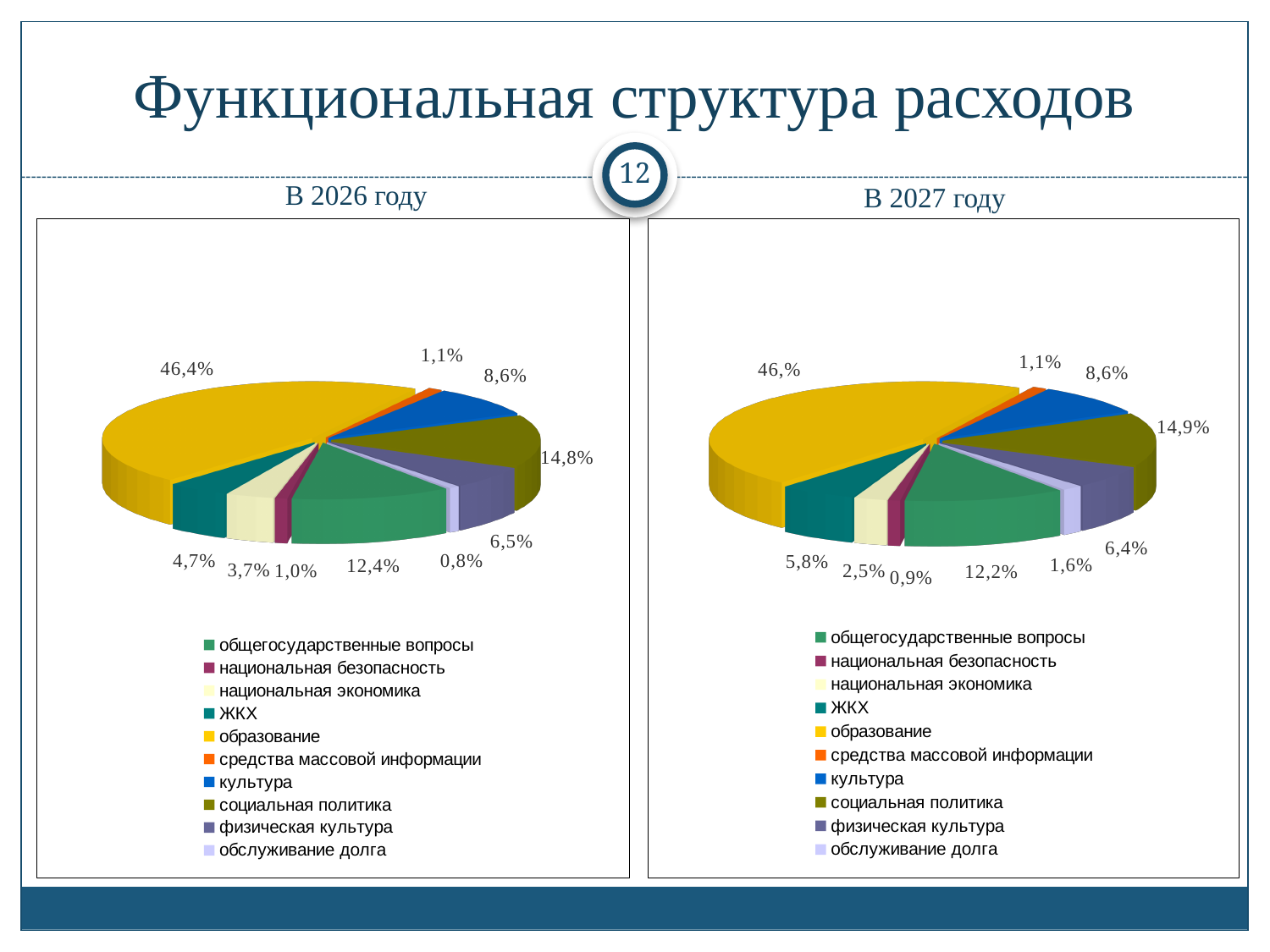
In the 'В 2026 году' chart, which category has the largest slice? образование In the 'В 2027 году' chart, which category has the smallest slice? национальная безопасность In the 'В 2026 году' chart, which category has the smallest slice? обслуживание долга In the 'В 2027 году' chart, which is larger: общегосударственные вопросы or культура? общегосударственные вопросы In the 'В 2027 году' chart, what share is shown for социальная политика? 14,9% In the 'В 2027 году' chart, what share is shown for ЖКХ? 5,8% What kind of chart is used on the slide for 'В 2026 году'? pie chart In the 'В 2026 году' chart, what is the difference in percentage points between общегосударственные вопросы (12,4%) and культура (8,6%)? 3,8 In the 'В 2026 году' chart, what share is shown for социальная политика? 14,8% In the 'В 2026 году' chart, what share is shown for образование? 46,4% How many categories does the legend of the 'В 2027 году' chart list? 10 In the 'В 2026 году' chart, what colour is the slice for образование? yellow